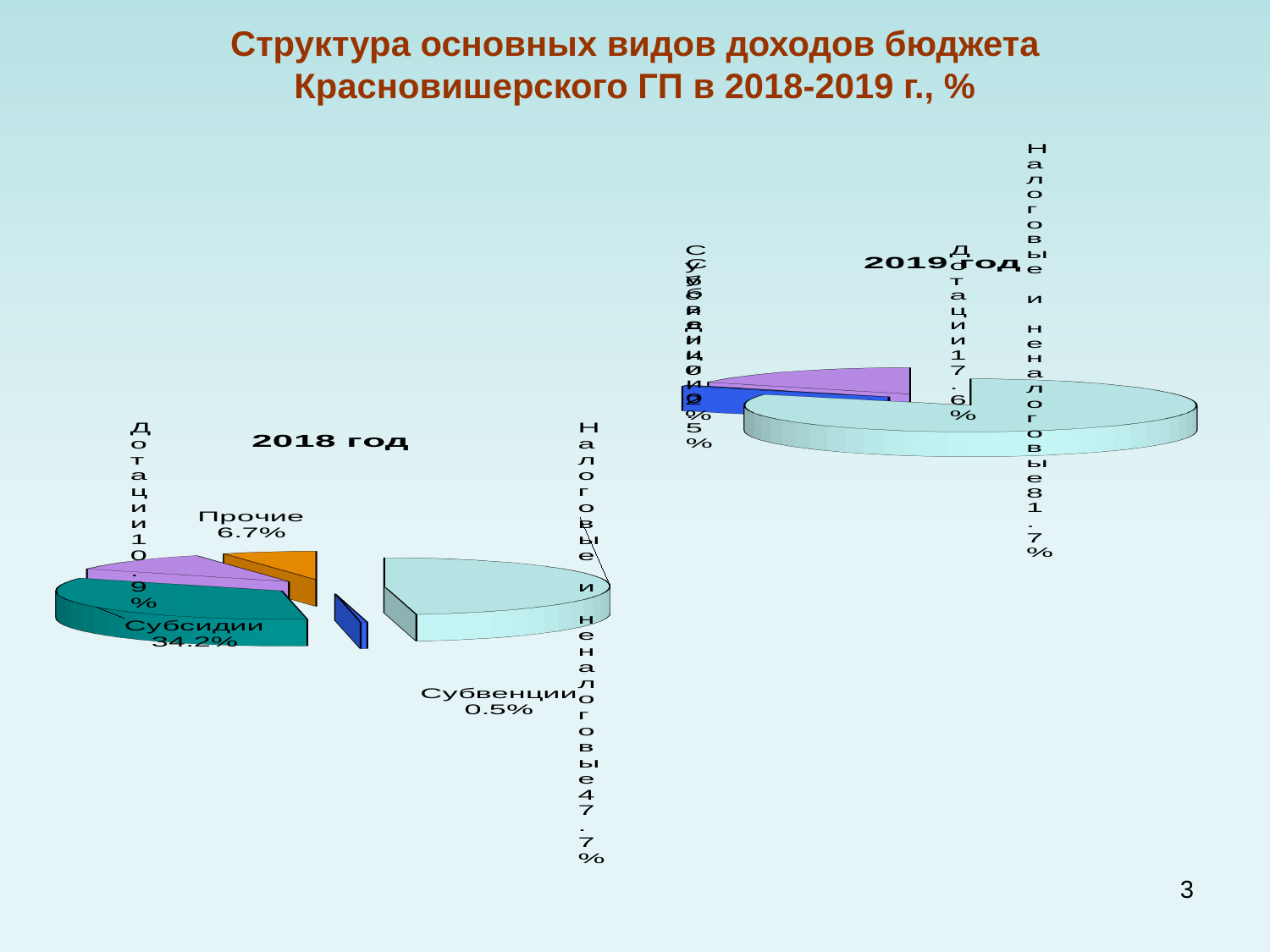
In the 2018 год chart, which category has the smallest share? Субвенции In the 2018 год chart, what is the share of Прочие? 6.7% In the 2019 год chart, what is the share of Налоговые и неналоговые? 81.7% In the 2018 год chart, which is larger: Субсидии or Дотации? Субсидии By how many percentage points did the share of Налоговые и неналоговые increase from the 2018 год chart to the 2019 год chart? 34.0% In the 2018 год chart, what is the share of Дотации? 10.9% In the 2019 год chart, what is the share of Дотации? 17.6% In the 2018 год chart, what is the share of Субвенции? 0.5% In the 2018 год chart, what is the share of Субсидии? 34.2% In the 2018 год chart, which category has the largest share? Налоговые и неналоговые What kind of charts are shown on the slide? Pie charts In the 2018 год chart, what is the share of Налоговые и неналоговые? 47.7%